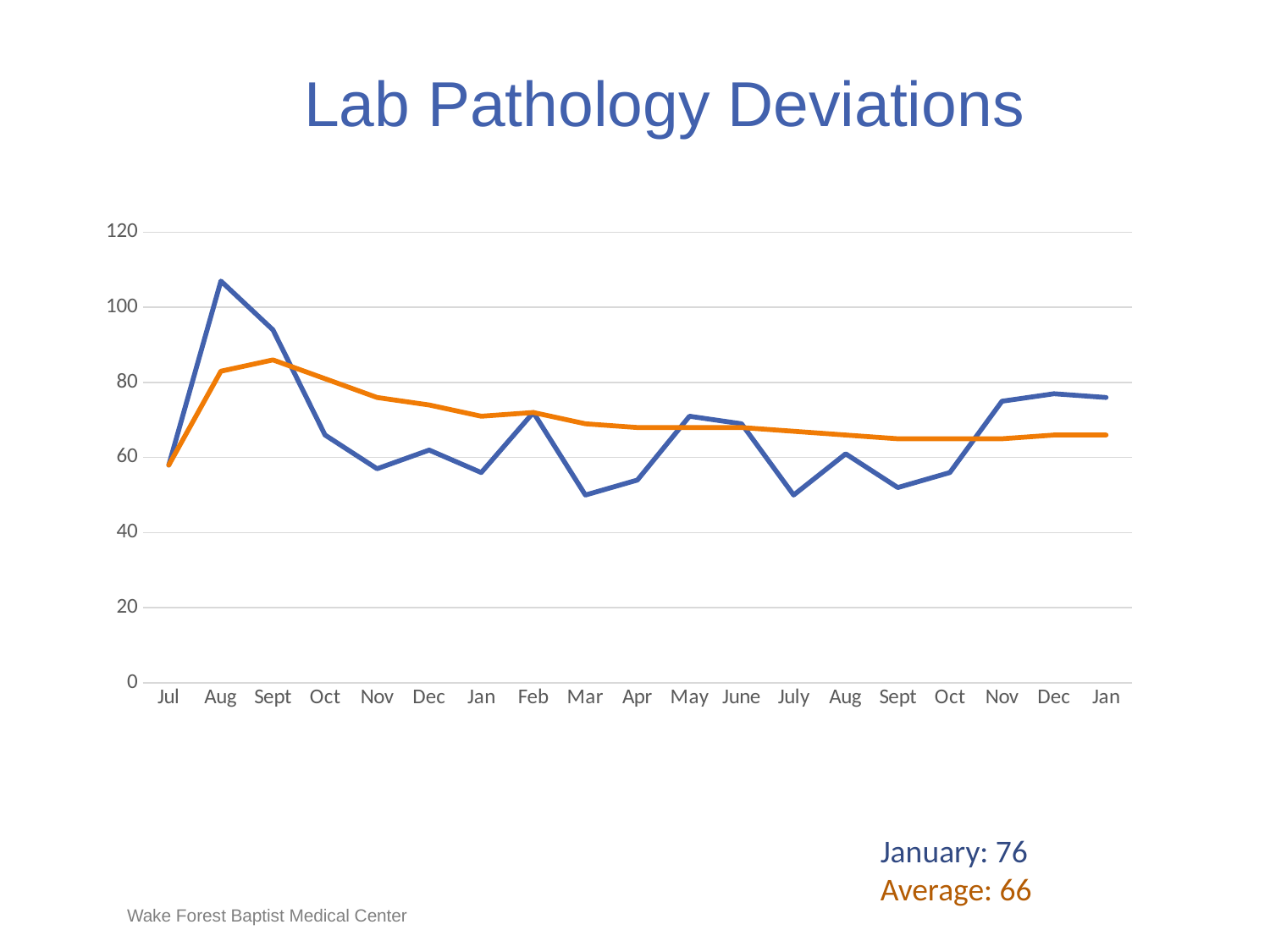
According to the text on the slide, what is the value for January? 76 Does the orange line rise or fall from the first Sept to the final Jan? fall According to the text on the slide, what is the Average value? 66 Which is larger on the blue line: the value at the first Aug or the value at the first Oct? Aug What kind of chart is shown on the slide? line chart How many lines are plotted on the chart? 2 What is the difference between the January value and the Average value shown on the slide? 10 Is the value of the blue line at Mar greater or less than 60? less How many points are plotted along the x axis of the chart? 19 What is the title of the chart? Lab Pathology Deviations Is the value of the blue line at the first Aug greater or less than 100? greater At which month does the blue line reach its highest value? Aug (the first Aug)